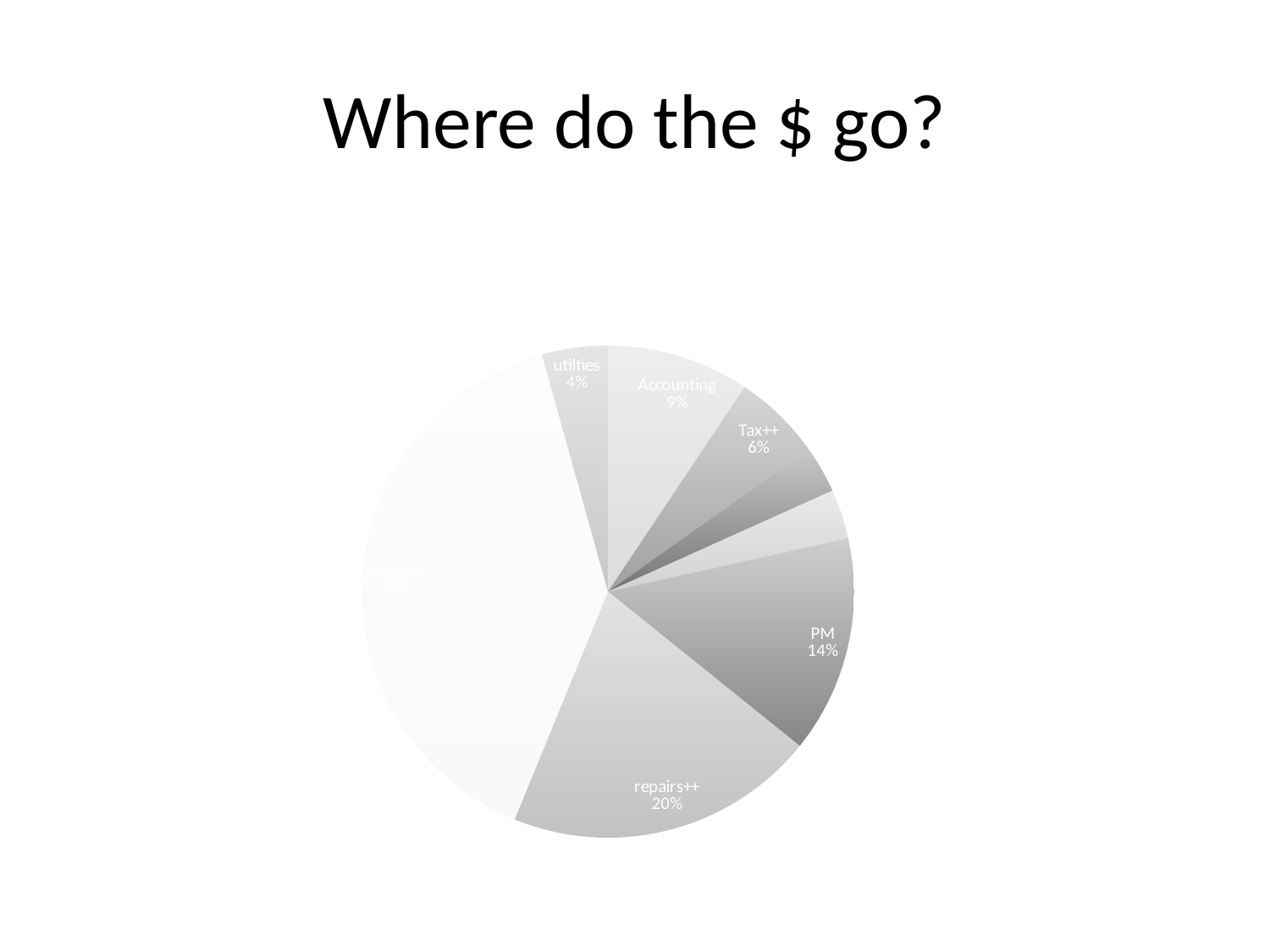
What percentage is shown for the Tax++ slice? 6% What is the title of the slide containing the chart? Where do the $ go? What percentage of the pie does the repairs++ slice represent? 20% By how many percentage points does the repairs++ slice exceed the PM slice? 6 percentage points What is the difference in percentage points between the PM slice and the utilities slice? 10 percentage points What is the difference in percentage points between the Accounting slice and the Tax++ slice? 3 percentage points Which slice is larger, repairs++ or PM? repairs++ What share of the pie is labelled PM? 14% What kind of chart is shown on the slide? Pie chart Which slice is larger, Accounting or Tax++? Accounting What percentage is shown for the utilities slice? 4% What percentage is shown for the Accounting slice? 9%